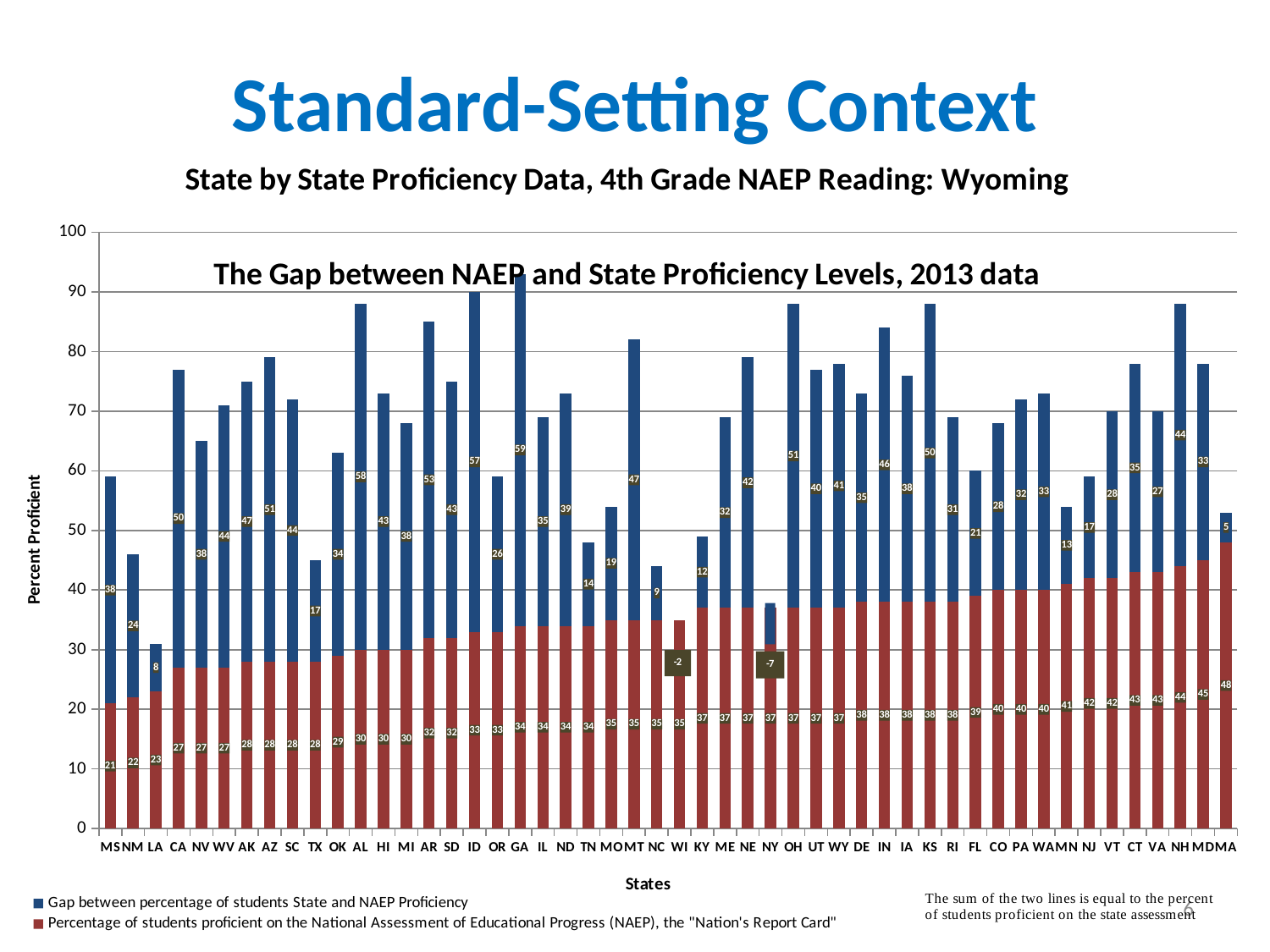
What is the title of the chart? The Gap between NAEP and State Proficiency Levels, 2013 data What is the gap between State and NAEP proficiency for NY? -7 What is the difference between the gap value for AL and the gap value for TX? 41 What is the gap between State and NAEP proficiency for GA? 59 What kind of chart is shown on the slide? Stacked bar chart Which state has the lowest percentage of students proficient on NAEP? MS What is the percentage of students proficient on NAEP for MS? 21 How many states are shown along the x axis? 50 Which has the larger gap between State and NAEP proficiency, CA or LA? CA How many series does the legend list? 2 What is the total of the stacked bar for GA (NAEP percentage plus gap)? 93 Which state has the highest percentage of students proficient on NAEP? MA